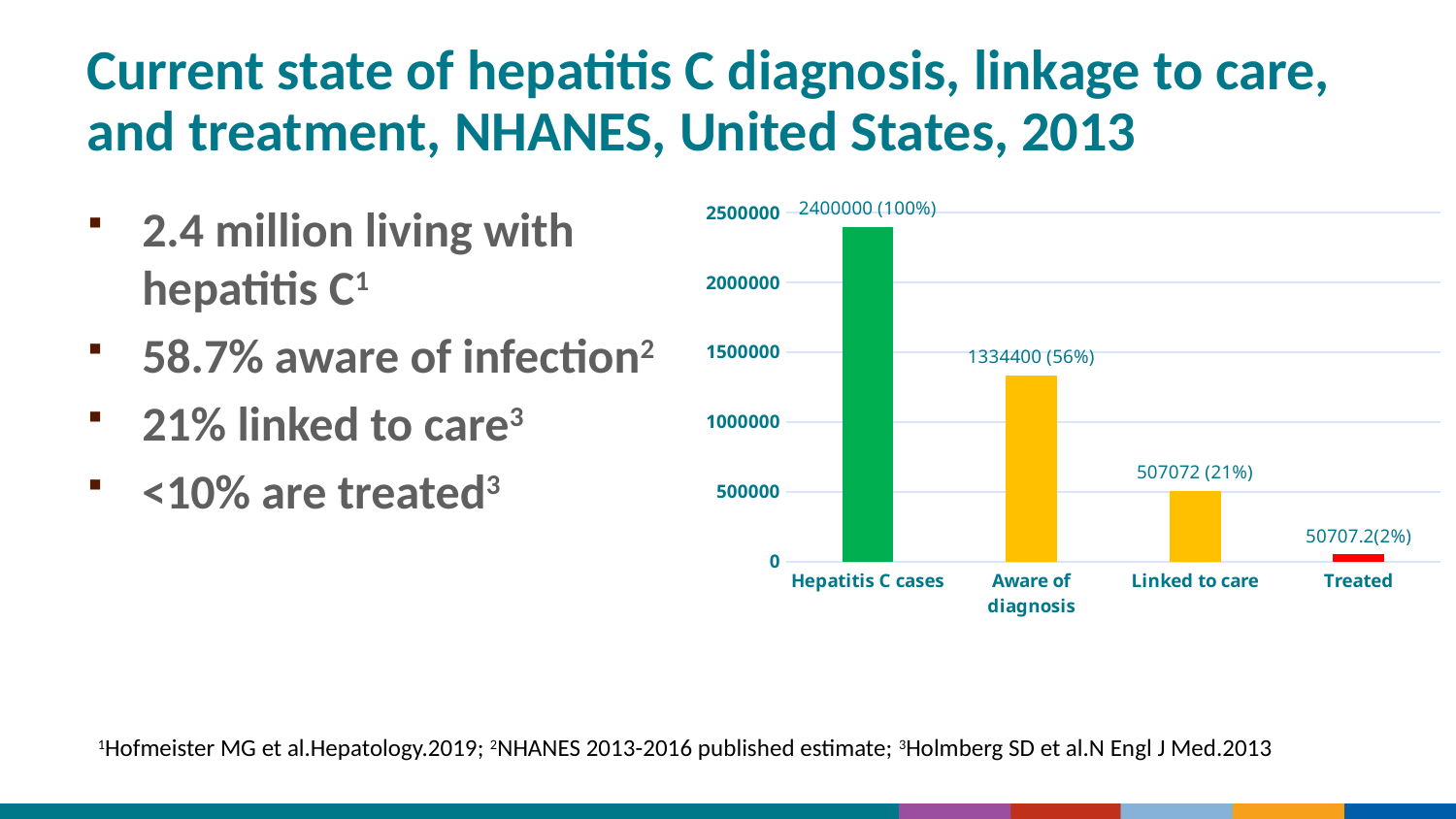
What value is shown for Hepatitis C cases? 2400000 (100%) Is the value for Linked to care greater or less than 1000000? less Which is larger, the value for Aware of diagnosis or the value for Linked to care? Aware of diagnosis What kind of chart is shown on the slide? bar chart What is the difference between the number of Hepatitis C cases and the number Aware of diagnosis? 1065600 What value is shown for Treated? 50707.2(2%) Which category has the lowest value? Treated Which category has the highest value? Hepatitis C cases Do the values rise or fall from left to right along the x axis? fall What value is shown for Aware of diagnosis? 1334400 (56%) How many categories are shown on the x axis? 4 What value is shown for Linked to care? 507072 (21%)